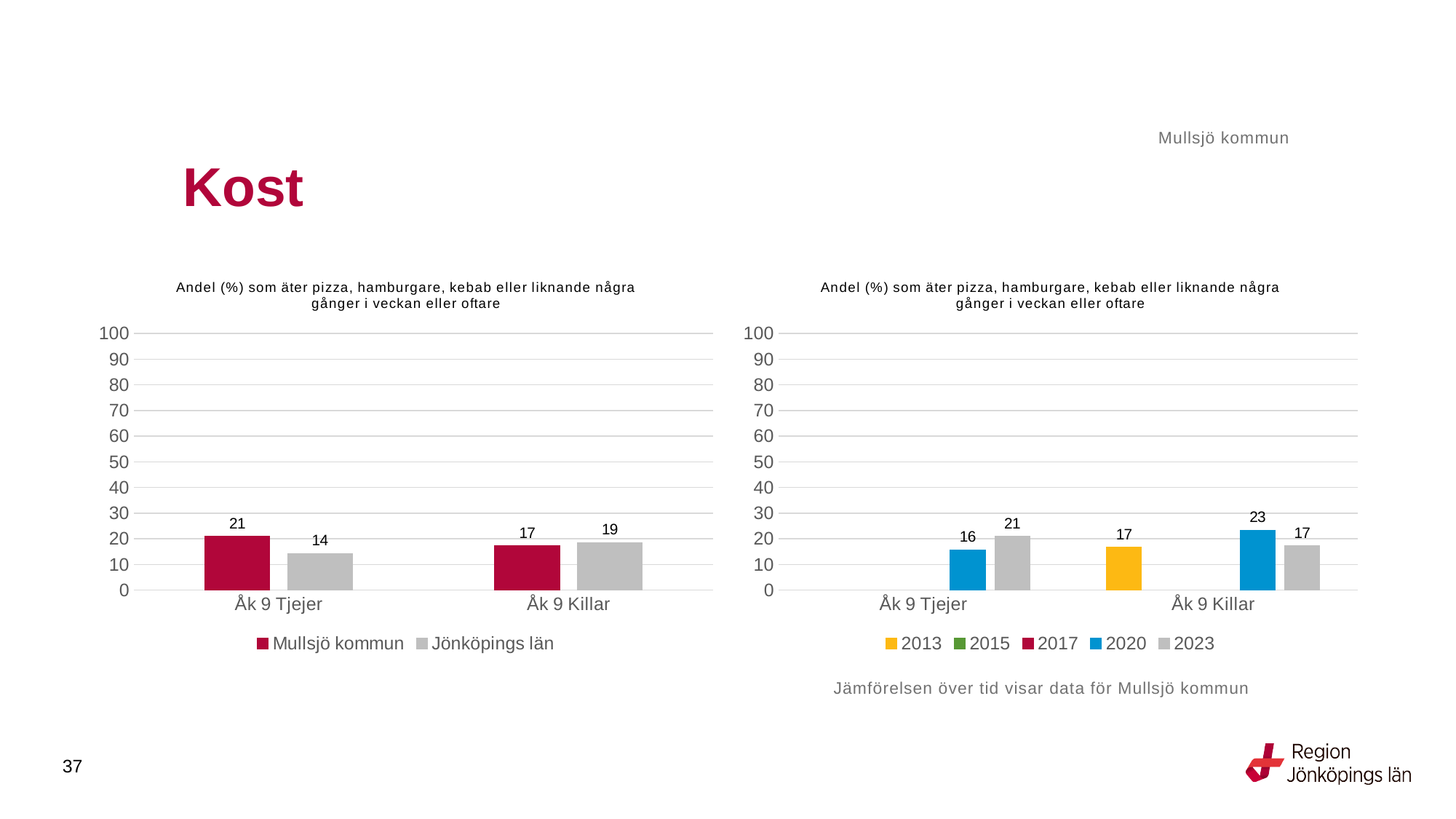
In the right chart, is the value for 2020 for Åk 9 Tjejer greater or less than 20? less What kind of chart is the left chart? Bar chart In the right chart, how many series does the legend list? 5 In the left chart, what is the difference between Mullsjö kommun and Jönköpings län for Åk 9 Tjejer? 7 In the right chart, what is the value for 2013 for Åk 9 Killar? 17 In the left chart, which is larger for Åk 9 Killar: Mullsjö kommun or Jönköpings län? Jönköpings län In the left chart, what is the value for Jönköpings län for Åk 9 Killar? 19 In the right chart, what is the difference between 2020 and 2023 for Åk 9 Killar? 6 In the right chart, what is the value for 2023 for Åk 9 Tjejer? 21 In the left chart, how many series does the legend list? 2 In the left chart, what is the value for Mullsjö kommun for Åk 9 Tjejer? 21 In the right chart, what is the value for 2020 for Åk 9 Killar? 23